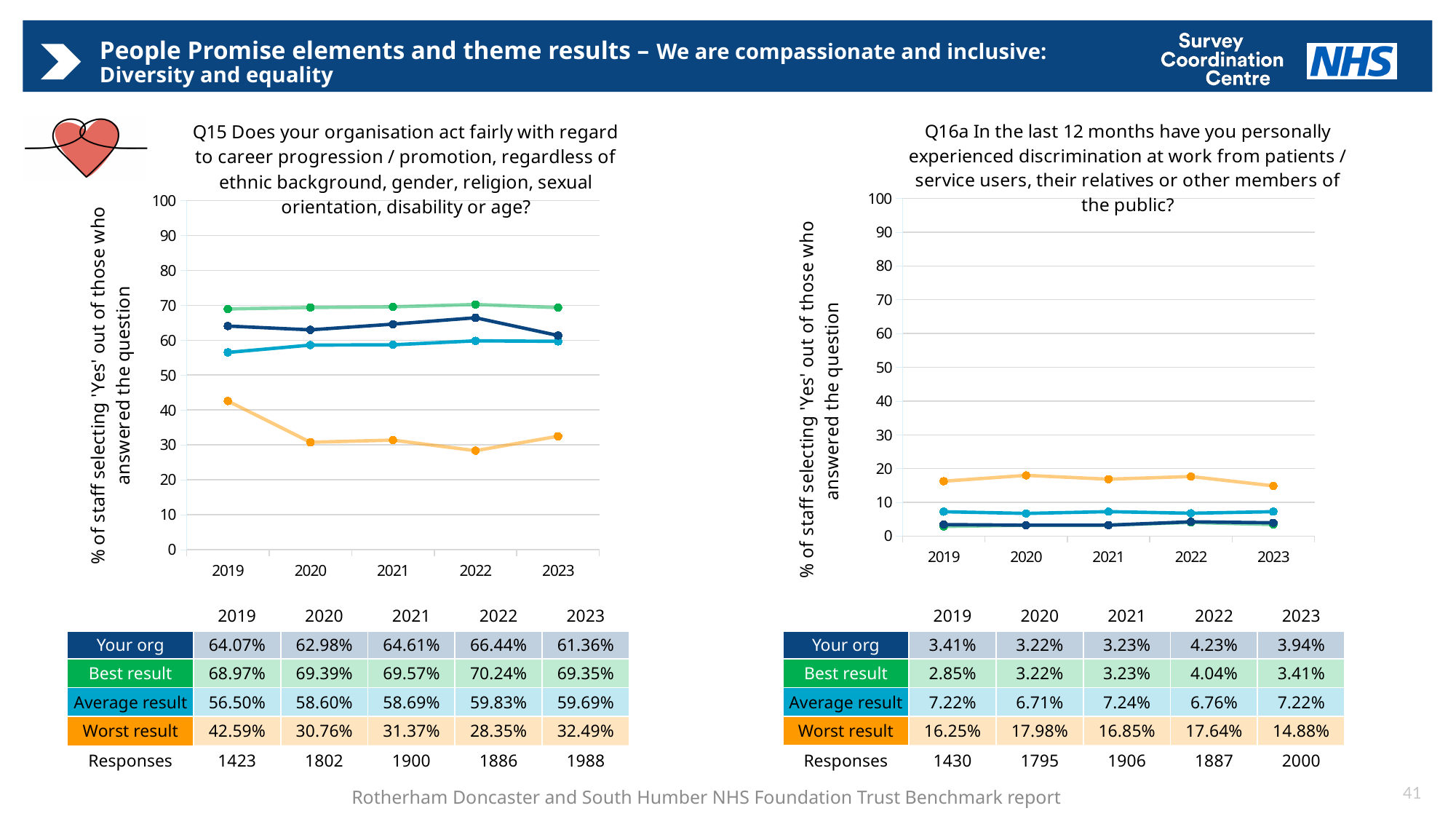
What type of chart is used for Q15 on the left? Line chart On the Q15 chart (left), what is the difference between the 'Best result' and 'Your org' values in 2023? 7.99 percentage points On the Q15 chart (left), in which year was the 'Your org' value highest? 2022 On the Q15 chart (left), what was the 'Your org' value in 2022? 66.44% On the Q16a chart (right), what was the 'Average result' value in 2021? 7.24% On the Q15 chart (left), in which year was the 'Worst result' value lowest? 2022 On the Q16a chart (right), how many responses were recorded in 2023? 2000 On the Q15 chart (left), is the 'Your org' value in 2023 greater or less than 60? greater On the Q16a chart (right), how many years are plotted on the x axis? 5 On the Q16a chart (right), which is larger in 2023: the 'Your org' value or the 'Best result' value? Your org On the Q16a chart (right), in which year was the 'Worst result' value highest? 2020 On the Q15 chart (left), what was the 'Worst result' value in 2019? 42.59%